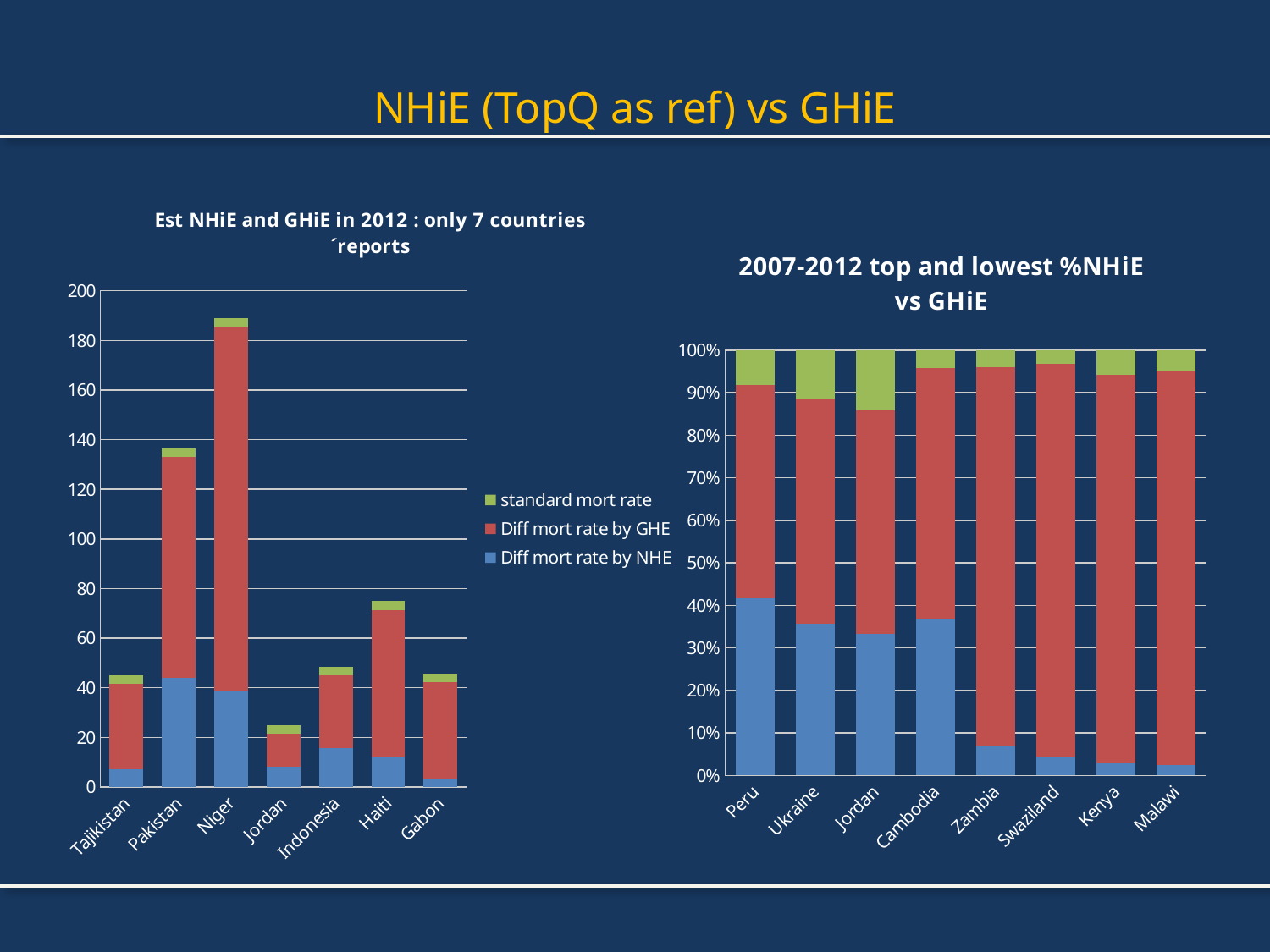
In the left chart 'Est NHiE and GHiE in 2012', is the total stacked bar for Pakistan greater or less than 120? greater In the left chart 'Est NHiE and GHiE in 2012', which country has the tallest stacked bar? Niger In the left chart 'Est NHiE and GHiE in 2012', which country has the larger total bar, Pakistan or Haiti? Pakistan In the left chart 'Est NHiE and GHiE in 2012', which country has the shortest stacked bar? Jordan Which series is shown in green in the legend of the left chart? standard mort rate In the right chart '2007-2012 top and lowest %NHiE vs GHiE', which country has the largest blue 'Diff mort rate by NHE' segment? Peru In the left chart 'Est NHiE and GHiE in 2012', is the total stacked bar for Haiti greater or less than 100? less How many series does the legend of the left chart 'Est NHiE and GHiE in 2012' list? 3 How many countries are shown on the x axis of the right chart '2007-2012 top and lowest %NHiE vs GHiE'? 8 In the right chart '2007-2012 top and lowest %NHiE vs GHiE', is the blue 'Diff mort rate by NHE' segment for Zambia greater or less than 10%? less How many countries are shown on the x axis of the left chart 'Est NHiE and GHiE in 2012'? 7 What type of chart is the left chart titled 'Est NHiE and GHiE in 2012 : only 7 countries ´reports'? Stacked bar chart